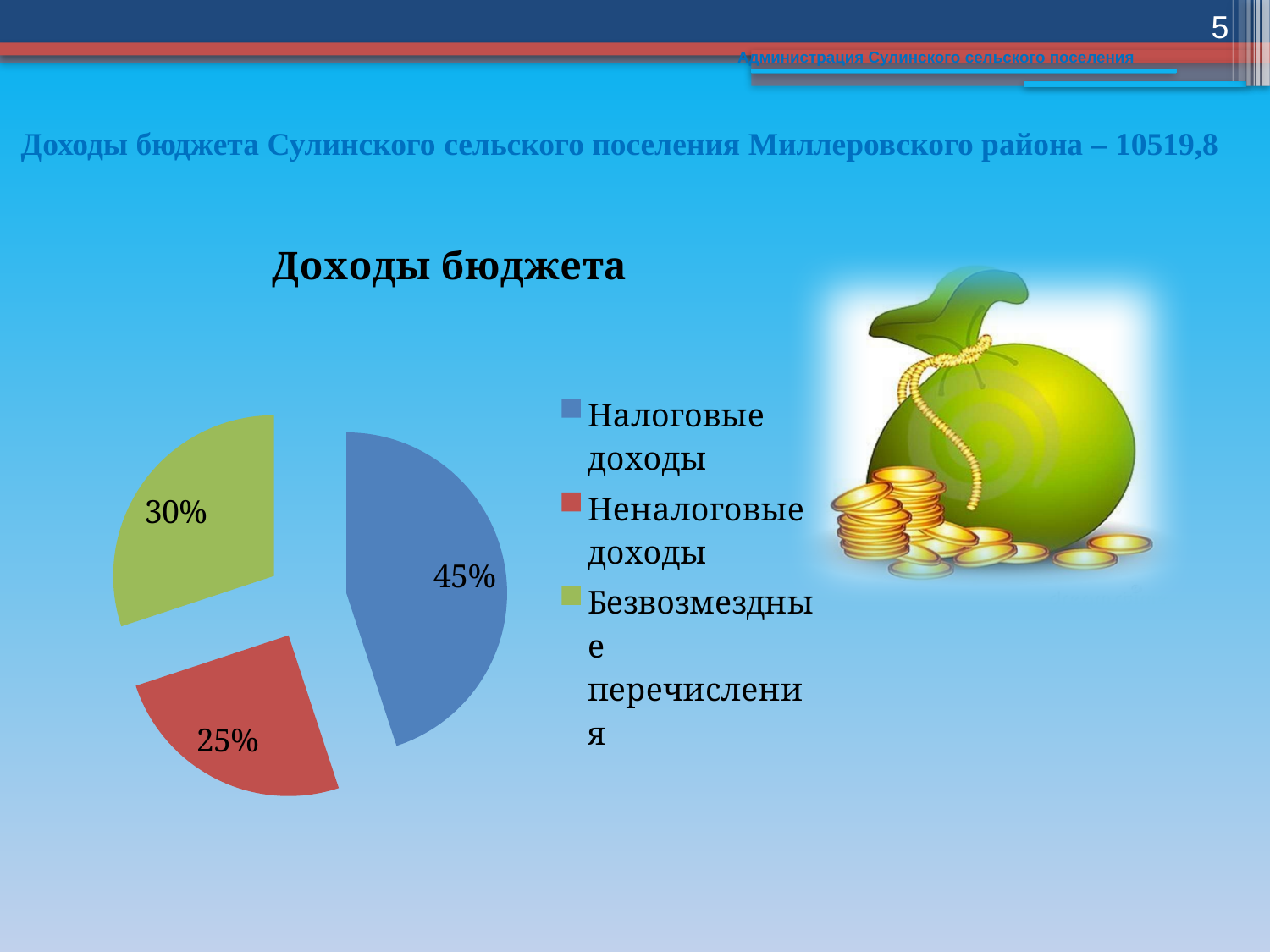
Which category has the largest share of the pie? Налоговые доходы What is the difference between the shares of Налоговые доходы and Неналоговые доходы? 20% What kind of chart is shown on the slide? pie chart Which category has the smallest share of the pie? Неналоговые доходы What colour is the slice for Неналоговые доходы? red What share of the pie is Безвозмездные перечисления? 30% What share of the pie is Налоговые доходы? 45% What is the difference between the shares of Безвозмездные перечисления and Неналоговые доходы? 5% What share of the pie is Неналоговые доходы? 25% Which is larger: the share of Безвозмездные перечисления or the share of Неналоговые доходы? Безвозмездные перечисления What is the title of the chart? Доходы бюджета How many categories does the pie chart have? 3